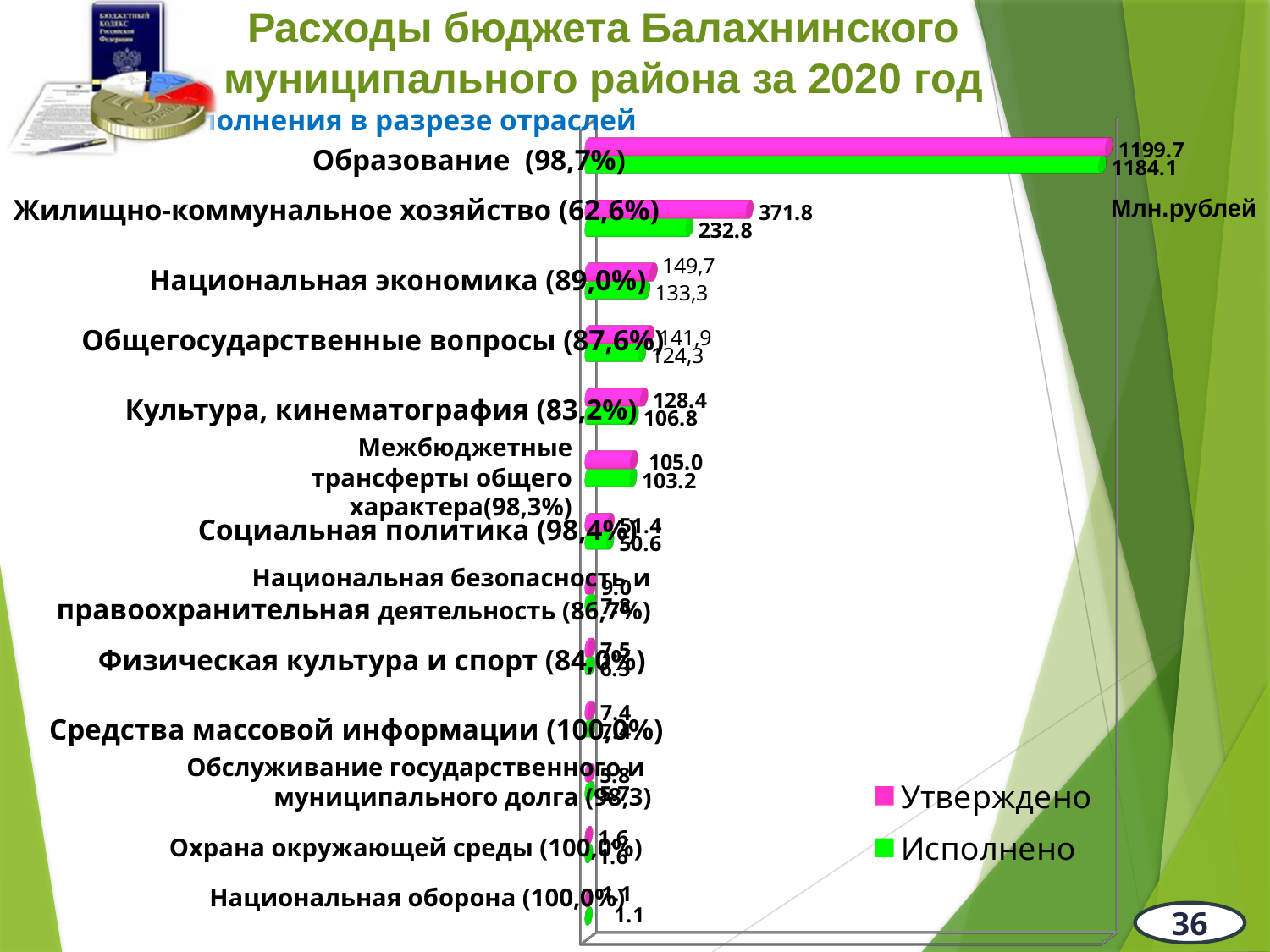
What is the Исполнено value for Межбюджетные трансферты общего характера? 103.2 What is the Утверждено value for Образование? 1199.7 What is the Исполнено value for Культура, кинематография? 106.8 What are the two series named in the legend? Утверждено and Исполнено What kind of chart is shown on the slide? bar chart What is the Утверждено value for Национальная экономика? 149,7 What is the Исполнено value for Жилищно-коммунальное хозяйство? 232.8 Which is larger for Общегосударственные вопросы: the Утверждено value or the Исполнено value? Утверждено Which category has the highest Утверждено value? Образование (98,7%) How many categories (expenditure sectors) are shown in the chart? 13 How many series does the legend list? 2 What is the difference between the Утверждено and Исполнено values for Жилищно-коммунальное хозяйство? 139.0